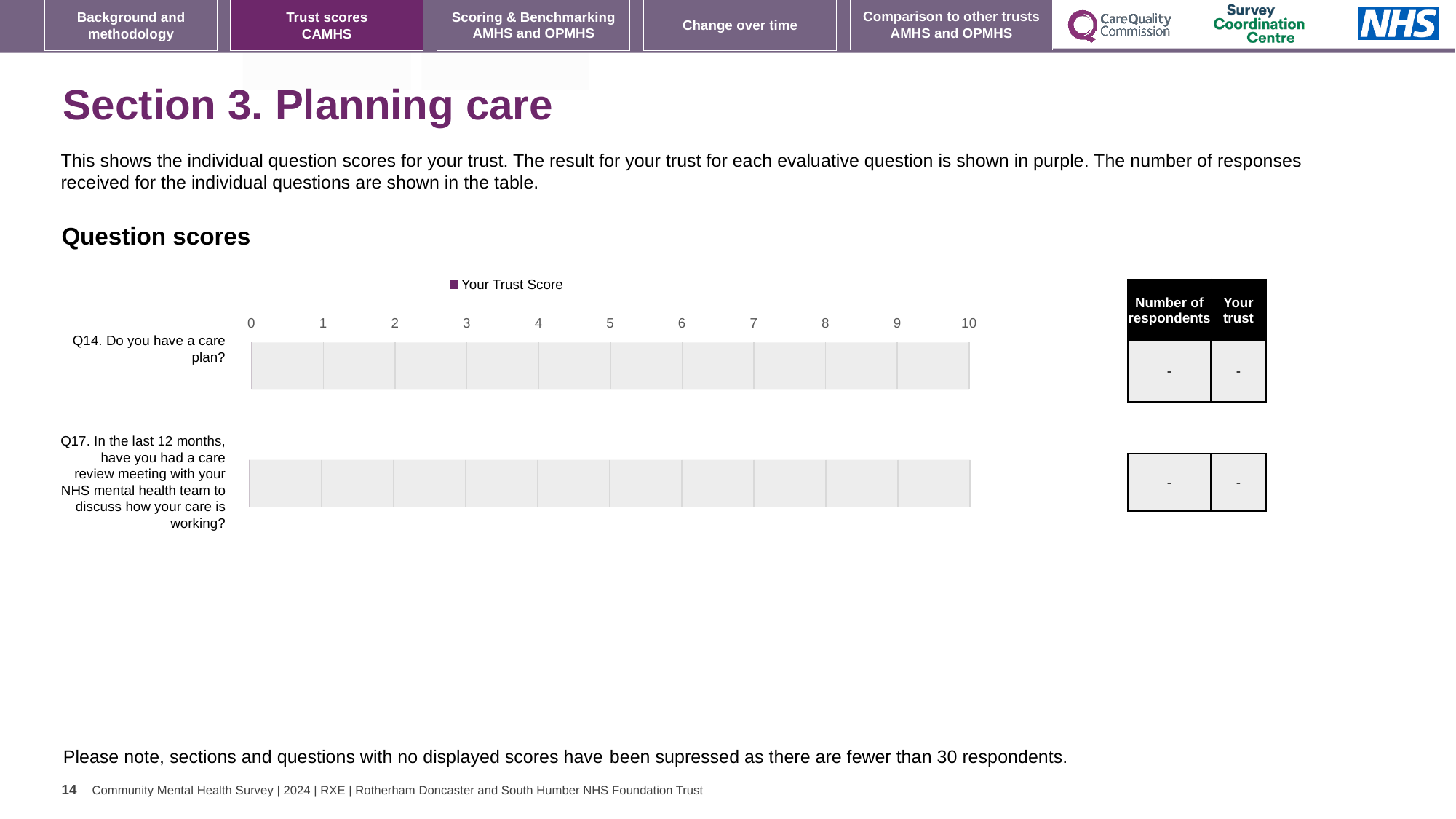
How many questions (categories) are listed on the chart? 2 What is the maximum value shown on the chart's axis? 10 What value is shown in the "Number of respondents" column of the table for Q17? - What kind of chart is shown under "Question scores"? bar chart What is the name of the series shown in the chart legend? Your Trust Score How many series does the chart legend list? 1 What value is shown in the "Your trust" column of the table for Q14? -